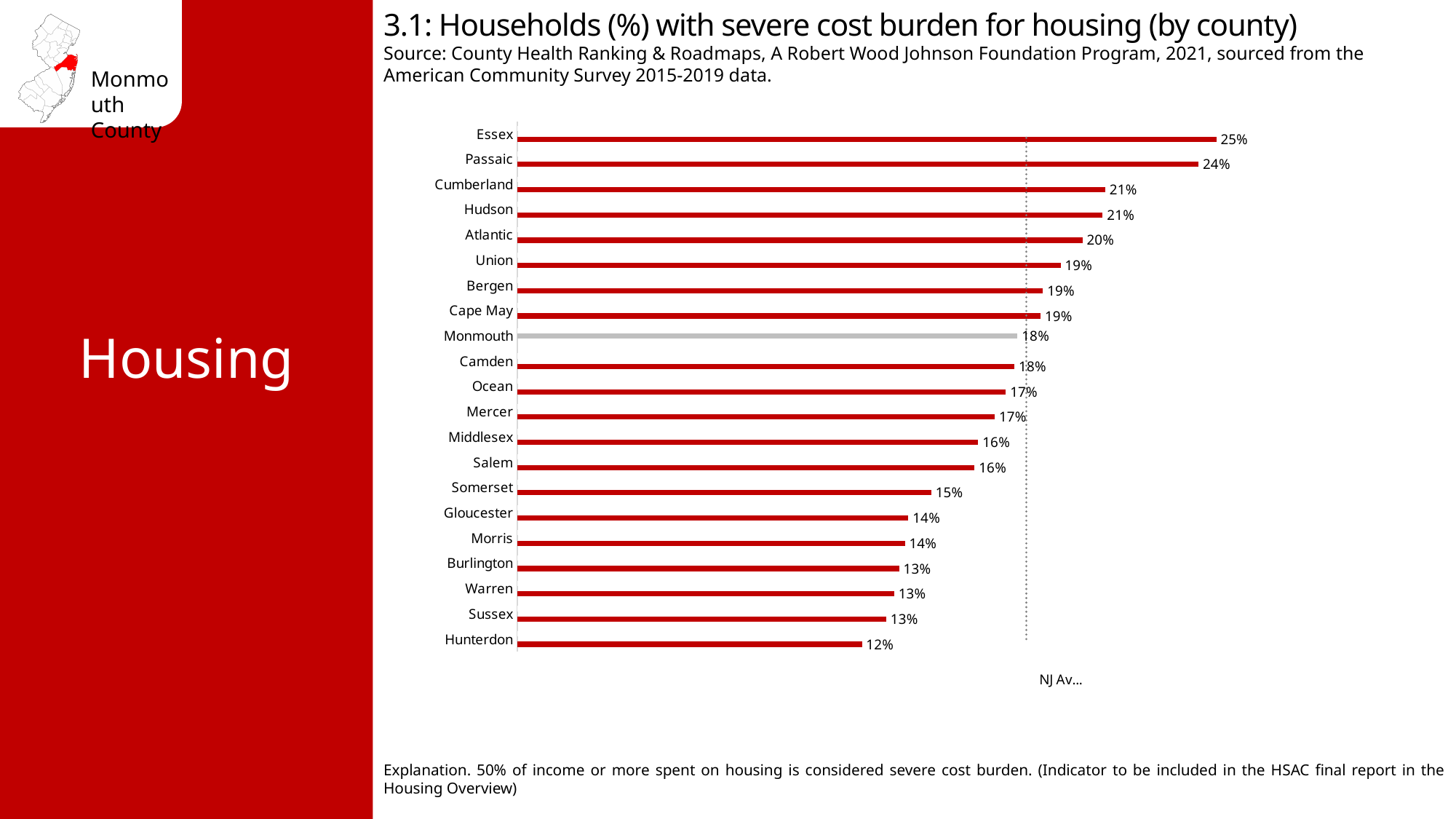
Which county's bar is shown in grey rather than red? Monmouth How many counties are shown in the chart? 21 Which has a larger value, Atlantic or Somerset? Atlantic Which county has the lowest value? Hunterdon Which county has the highest value? Essex What is the value for Essex? 25% What kind of chart is this? Bar chart What is the difference between the values for Passaic and Monmouth? 6% What is the value for Somerset? 15% What is the value for Monmouth? 18% What is the difference between the values for Essex and Hunterdon? 13% What is the value for Hunterdon? 12%